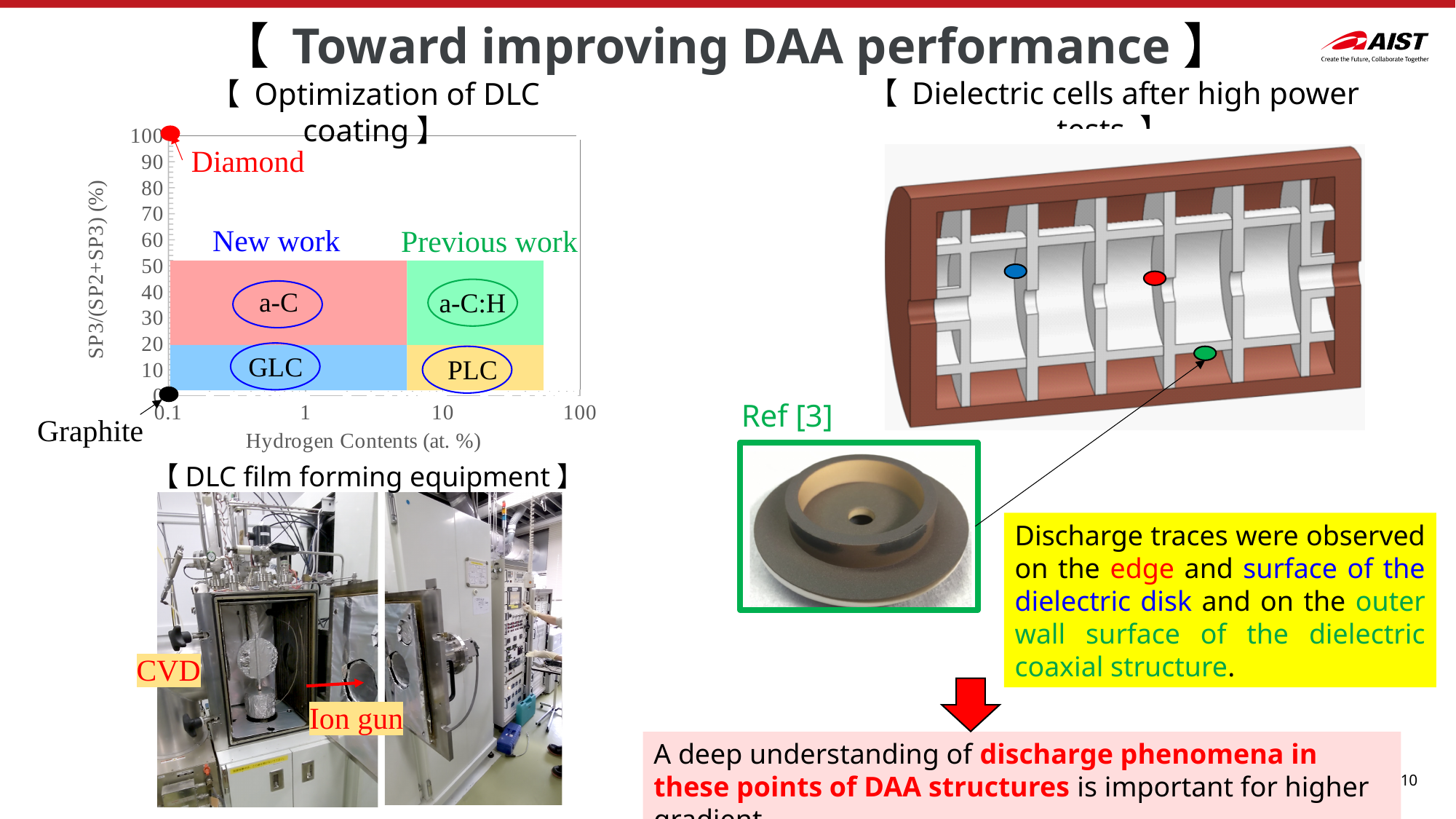
What is the label of the x axis of the chart? Hydrogen Contents (at. %) How many coloured coating regions (a-C, GLC, a-C:H, PLC) are shown on the chart? 4 Is the SP3/(SP2+SP3) value of the PLC region greater or less than 20? less Which labelled material has the lowest SP3/(SP2+SP3) value on the chart? Graphite What SP3/(SP2+SP3) value is marked for Diamond on the chart? 100 Which two coating regions are grouped under "Previous work" on the chart? a-C:H and PLC What is the label of the y axis of the chart? SP3/(SP2+SP3) (%) Is the SP3/(SP2+SP3) value of the a-C region greater or less than 20? greater What SP3/(SP2+SP3) value is marked for Graphite on the chart? 0 Which labelled material has the highest SP3/(SP2+SP3) value on the chart? Diamond Which has the higher SP3/(SP2+SP3) value on the chart, the a-C:H region or the GLC region? a-C:H Which two coating regions are grouped under "New work" on the chart? a-C and GLC